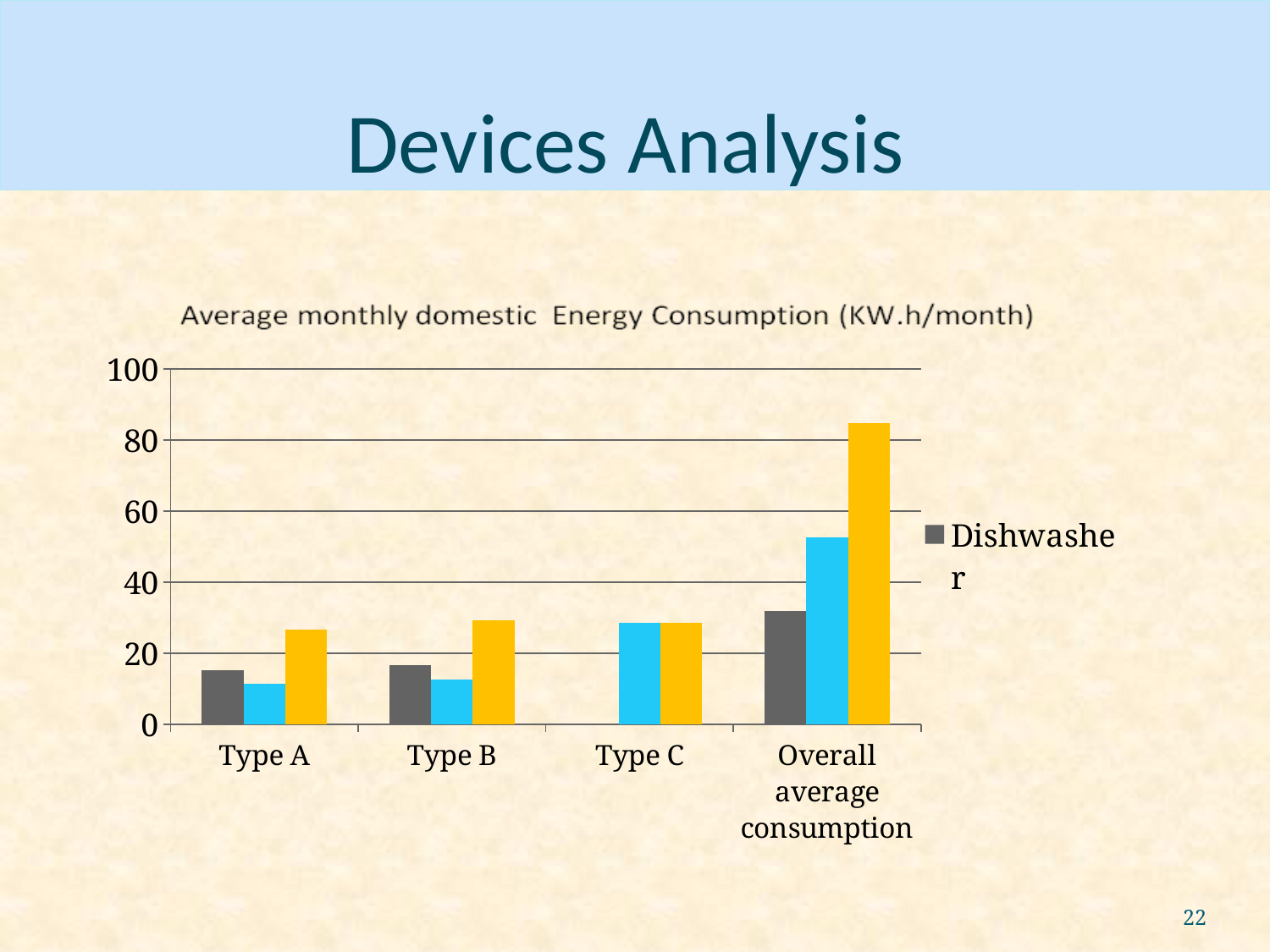
How many categories are shown on the x axis of the chart? 4 Is the Dishwasher value for Type A greater or less than 20? less Is the Dishwasher value for Overall average consumption greater or less than 40? less Which series is named in the chart's legend? Dishwasher What is the title of the chart? Average monthly domestic Energy Consumption (KW.h/month) Is the Dishwasher value for Type B greater or less than 20? less Which category has the highest Dishwasher value? Overall average consumption Which has the larger Dishwasher value, Type A or Overall average consumption? Overall average consumption What kind of chart is shown on the slide? bar chart What is the highest value shown on the y axis of the chart? 100